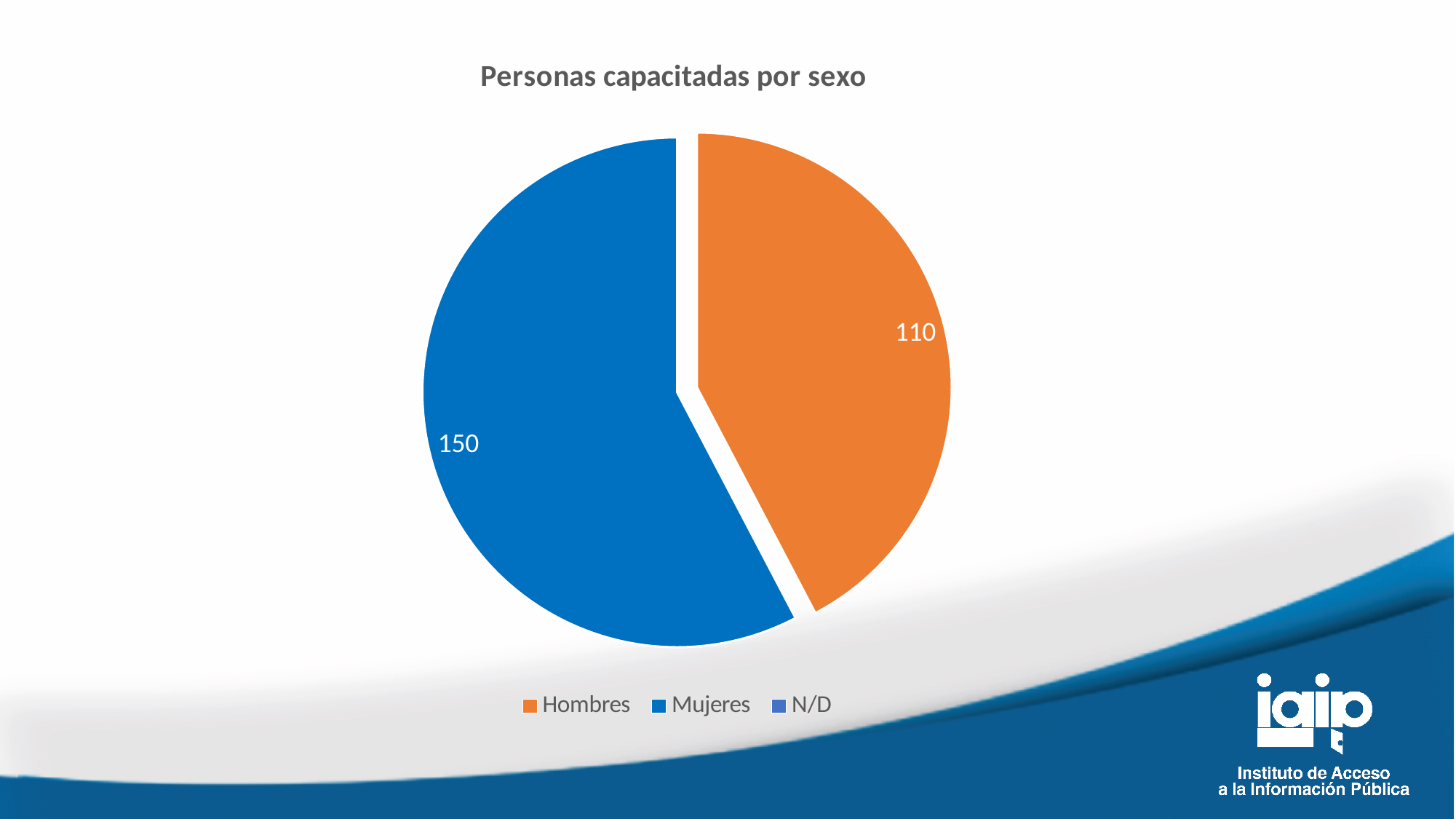
How many slices with data labels are visible in the pie? 2 Which category has the largest slice of the pie? Mujeres What colour is the Hombres slice? orange Which of the two labelled slices, Hombres or Mujeres, is smaller? Hombres What is the value for Hombres? 110 Is the value for Mujeres larger or smaller than the value for Hombres? larger What is the title of the chart? Personas capacitadas por sexo What is the value for Mujeres? 150 What type of chart is shown on the slide? pie chart What is the difference between the values for Mujeres and Hombres? 40 How many entries does the legend list? 3